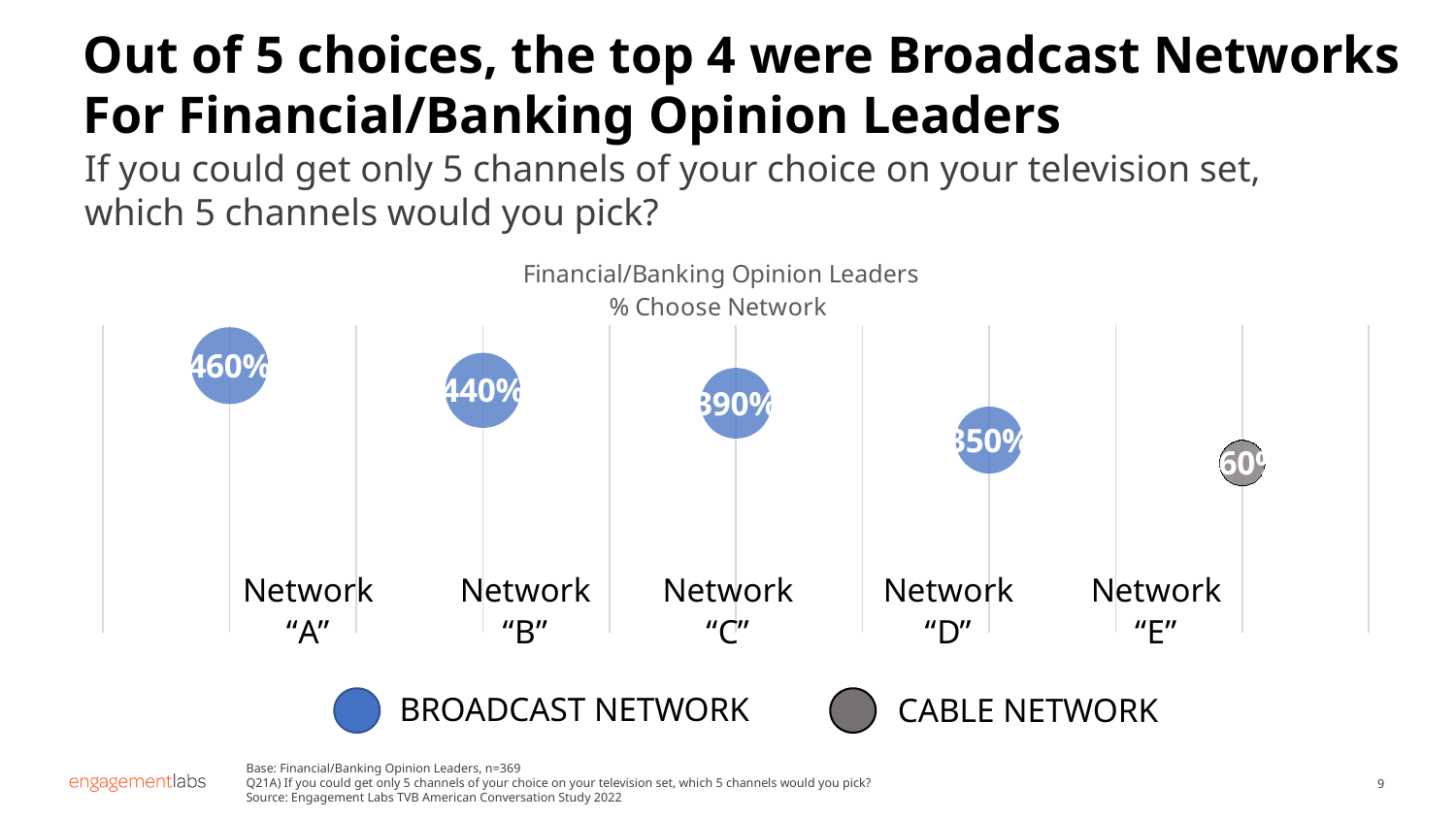
How many entries does the chart legend list? 2 Which has the larger value, Network "B" or Network "D"? Network "B" Which has the larger value, Network "A" or Network "D"? Network "A" Which network has the highest % Choose Network value? Network "A" What kind of chart is shown on the slide? bubble chart Which network has the lowest % Choose Network value? Network "E" How many networks are plotted on the chart? 5 Which has the larger value, Network "C" or Network "E"? Network "C" What are the two legend entries on the chart? Broadcast Network and Cable Network Do the values rise or fall moving from Network "A" to Network "E"? fall Which network is shown as a Cable Network (grey bubble)? Network "E"